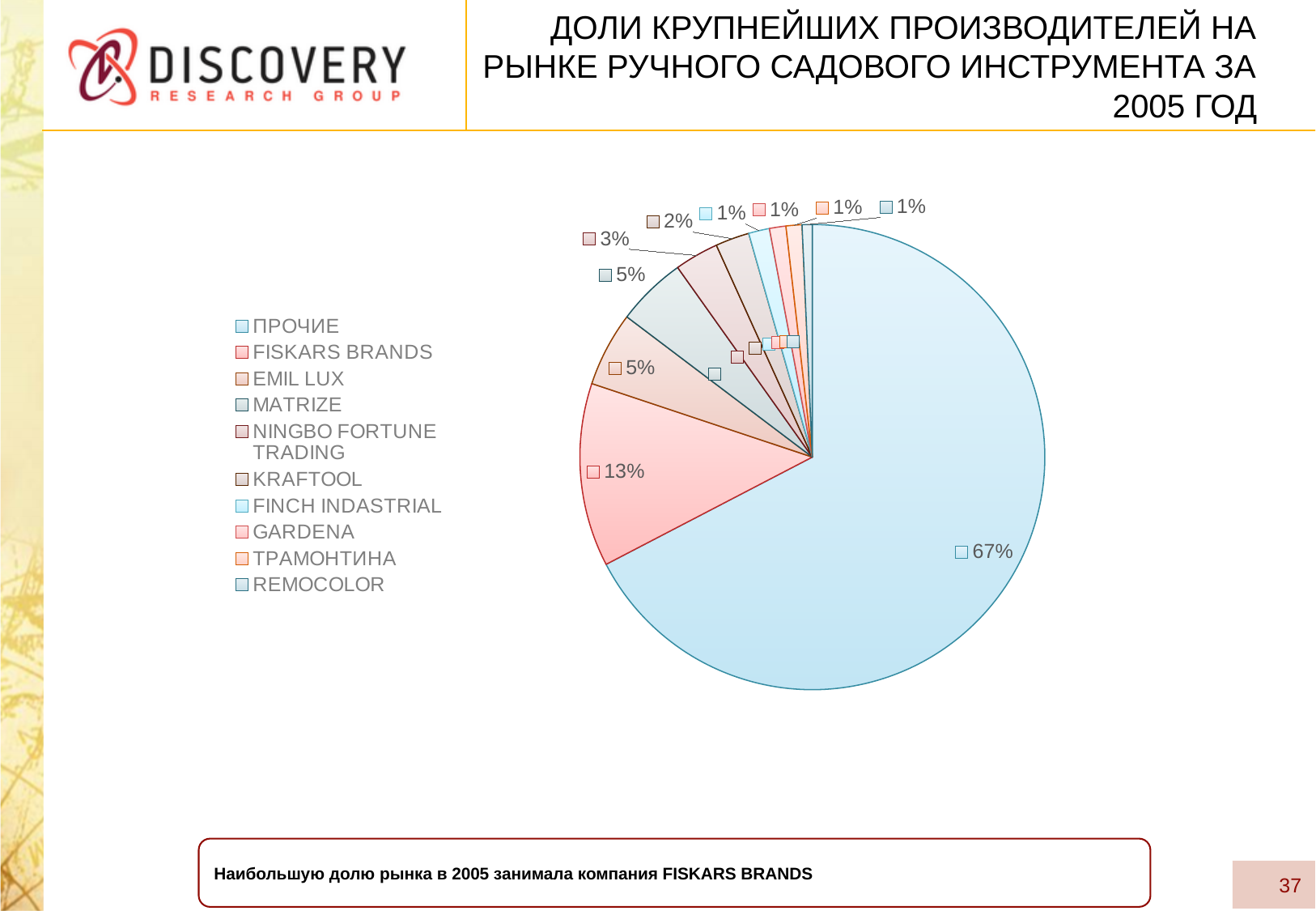
What share of the market does ПРОЧИЕ hold in the pie chart? 67% What kind of chart is shown on the slide? pie chart Which is larger, the share of NINGBO FORTUNE TRADING or the share of KRAFTOOL? NINGBO FORTUNE TRADING How many categories in the pie chart have a share of 1%? 4 What share does FISKARS BRANDS hold in the pie chart? 13% Which named manufacturer (excluding ПРОЧИЕ) has the largest share? FISKARS BRANDS What share does EMIL LUX hold? 5% Which category has the largest slice of the pie? ПРОЧИЕ What share does NINGBO FORTUNE TRADING hold? 3% How many categories does the legend of the pie chart list? 10 What share does KRAFTOOL hold? 2% What is the difference in share between ПРОЧИЕ and FISKARS BRANDS? 54 percentage points